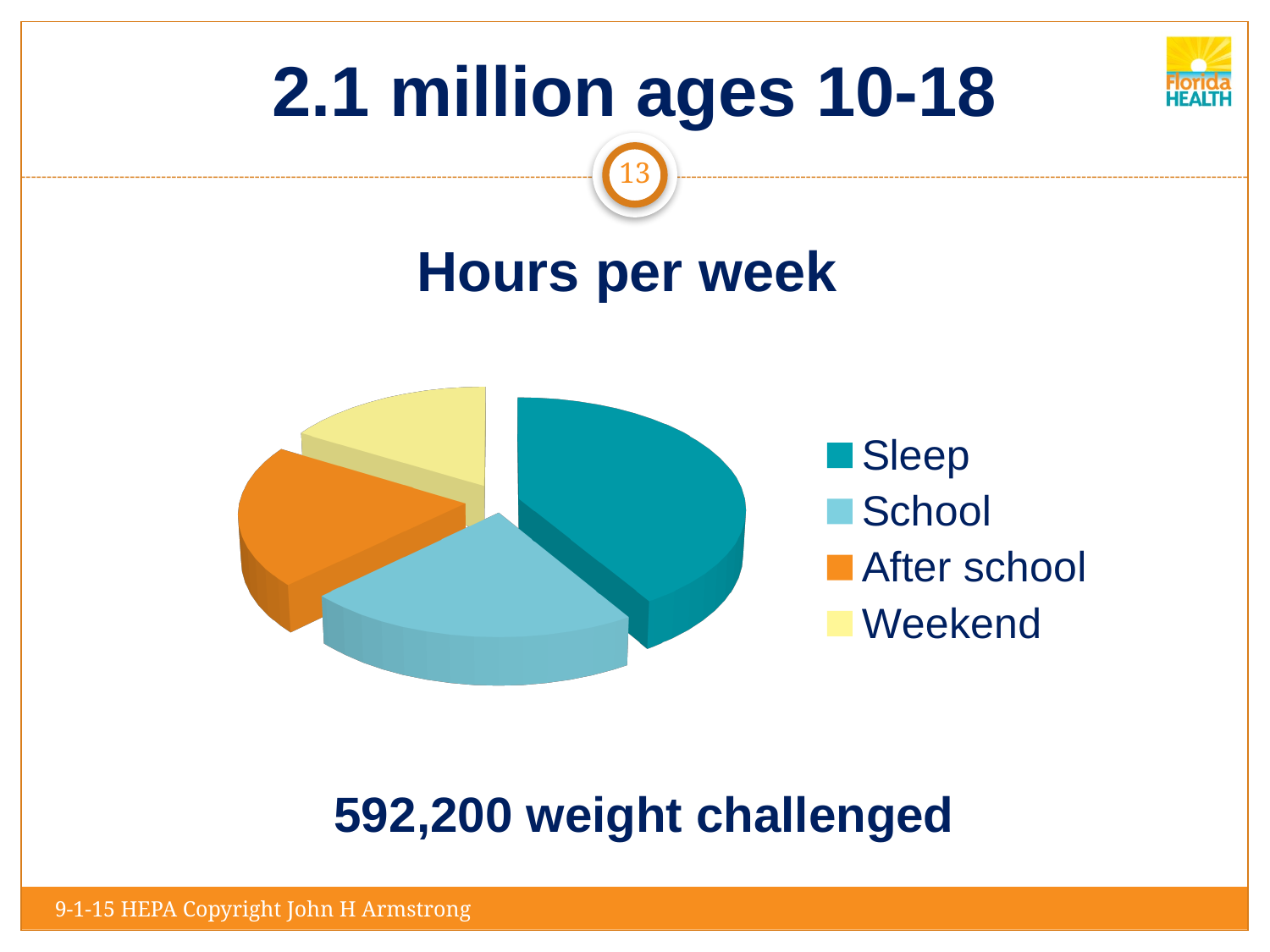
What kind of chart is shown on the slide? Pie chart Which slice is larger, Sleep or School? Sleep How many entries does the legend of the pie chart list? 4 Which slice is larger, School or Weekend? School What is the title of the pie chart? Hours per week What colour is the After school slice in the pie chart? Orange Which category has the largest slice of the pie chart? Sleep How many slices does the pie chart have? 4 Which category has the smallest slice of the pie chart? Weekend Which slice is larger, After school or Weekend? After school